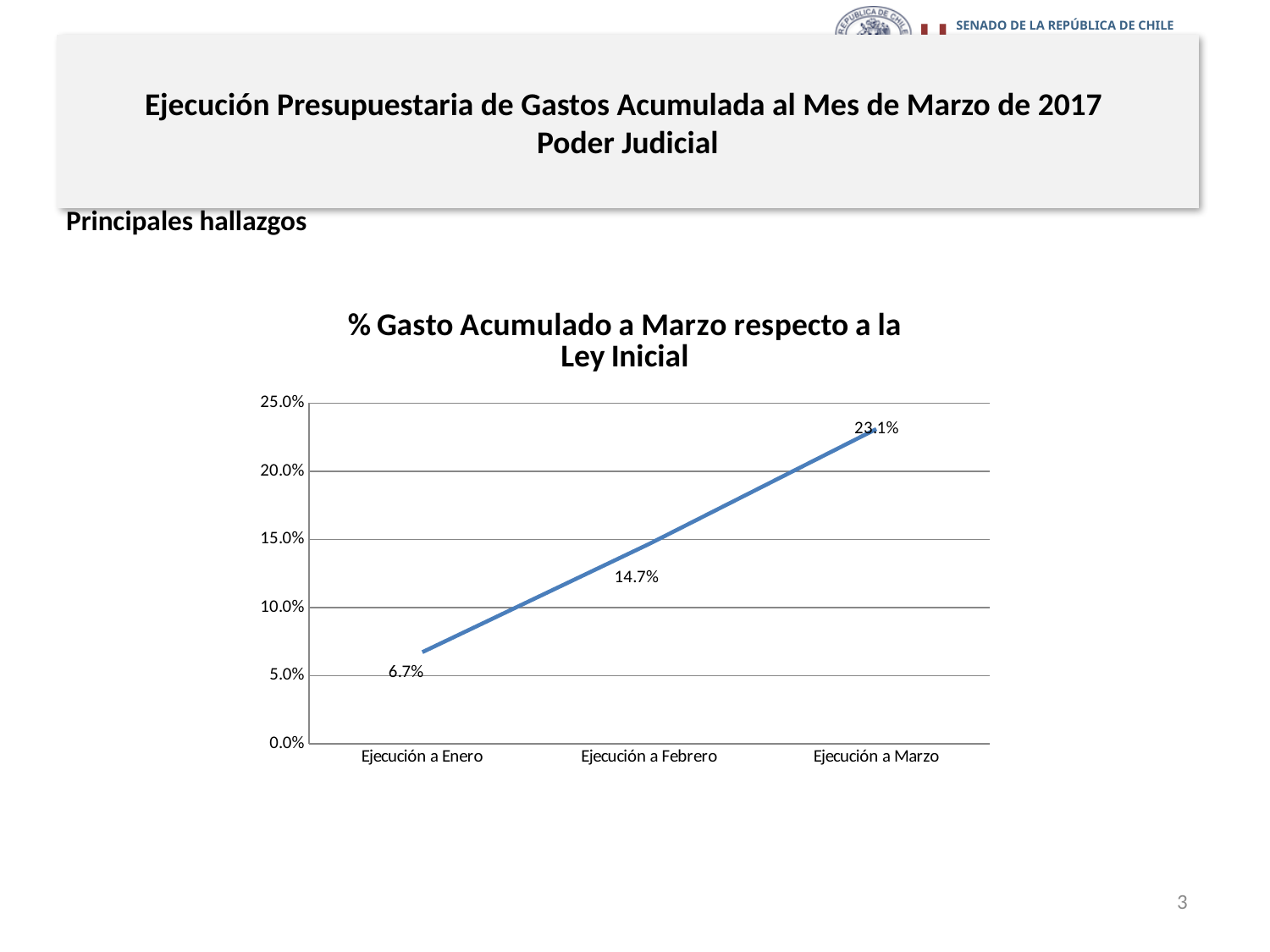
What is the difference between the values for Ejecución a Marzo and Ejecución a Febrero? 8.4% What is the difference between the values for Ejecución a Febrero and Ejecución a Enero? 8.0% Which category has the highest value? Ejecución a Marzo What is the value for Ejecución a Febrero? 14.7% Which category has the lowest value? Ejecución a Enero Do the values rise or fall from Ejecución a Enero to Ejecución a Marzo? rise What is the value for Ejecución a Marzo? 23.1% What kind of chart is shown on the slide? line chart Which is larger, the value for Ejecución a Febrero or Ejecución a Enero? Ejecución a Febrero How many categories are plotted on the x axis? 3 Is the value for Ejecución a Marzo greater or less than 20.0%? greater What is the value for Ejecución a Enero? 6.7%